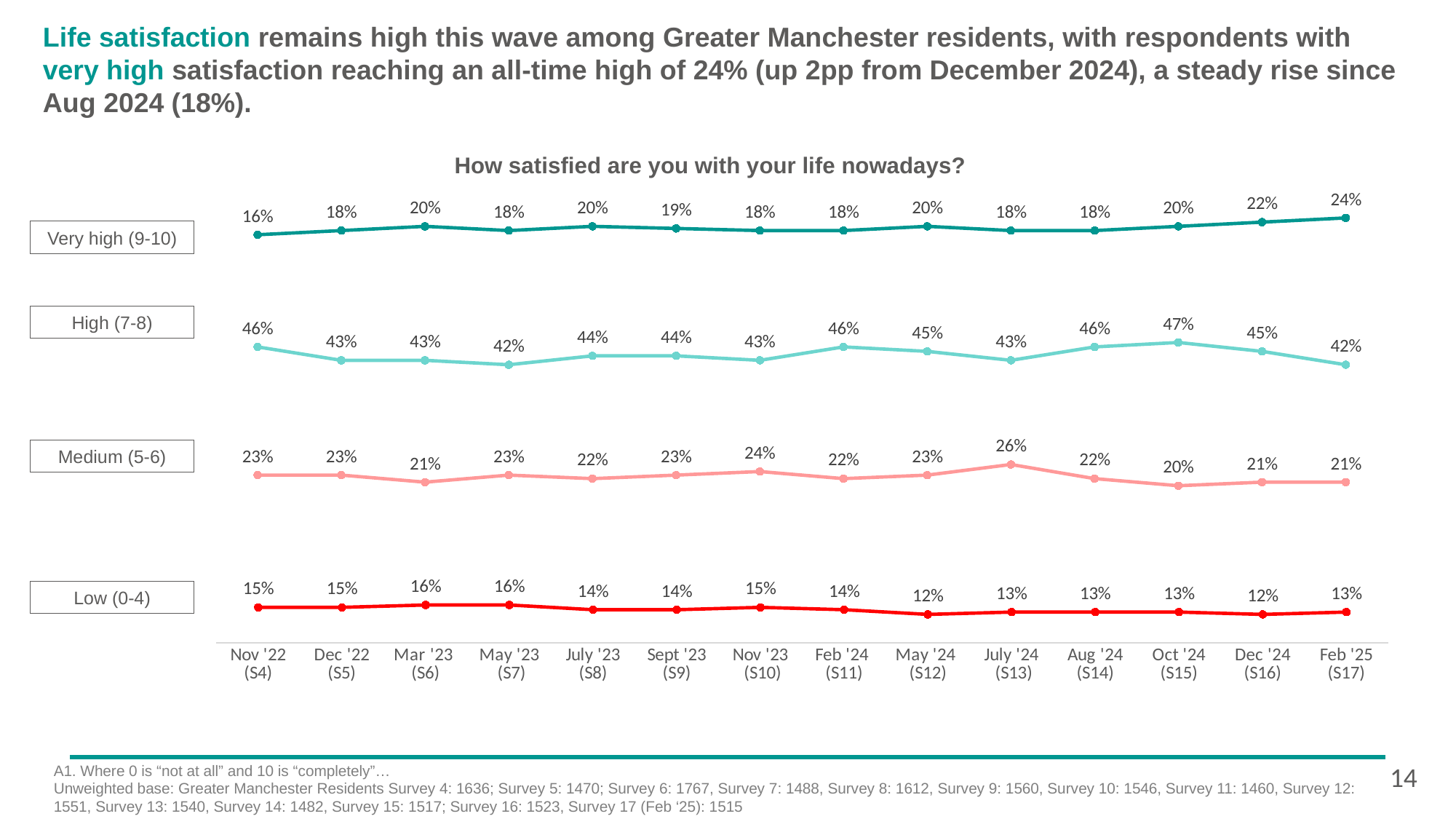
How many series are plotted on the chart? 4 How many survey waves are shown on the x axis? 14 What is the value for Very high (9-10) in Feb '25 (S17)? 24% What is the difference between the Very high (9-10) values in Feb '25 (S17) and Nov '22 (S4)? 8 percentage points What is the value for Low (0-4) in Nov '22 (S4)? 15% What type of chart is shown on the slide? Line chart What is the title of the chart? How satisfied are you with your life nowadays? In which survey wave does the High (7-8) series reach its highest value? Oct '24 (S15) In which survey wave does the Very high (9-10) series reach its highest value? Feb '25 (S17) Which is larger in Feb '25 (S17): the High (7-8) value or the Medium (5-6) value? High (7-8) What is the value for High (7-8) in Oct '24 (S15)? 47% What is the value for Medium (5-6) in July '24 (S13)? 26%